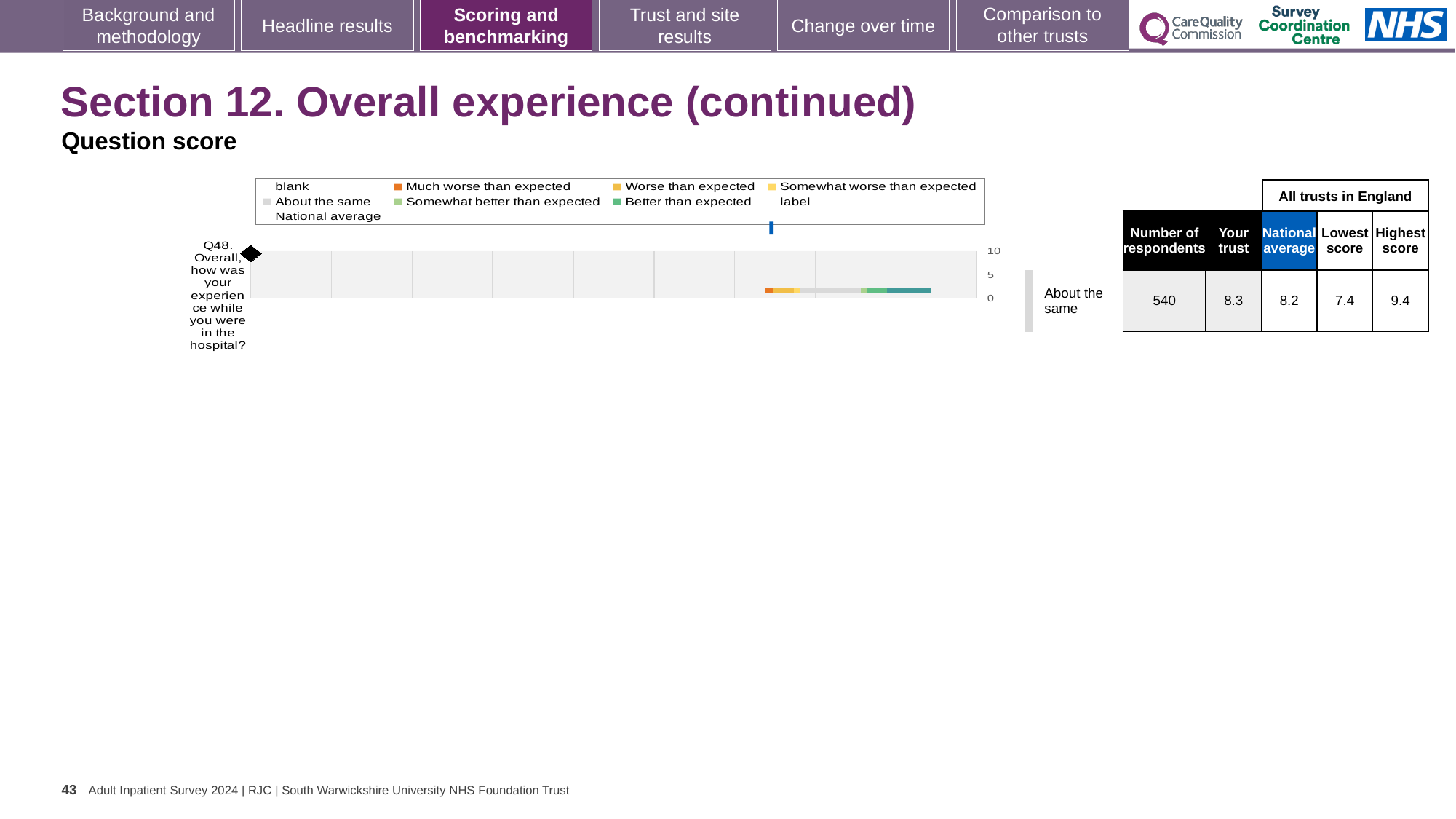
What is the lowest score among all trusts in England for Q48? 7.4 Which benchmarking category is Q48 assigned to? About the same What is the maximum value shown on the chart's score axis? 10 What is the 'Your trust' score for Q48 (Overall, how was your experience while you were in the hospital?)? 8.3 What is the national average score for Q48? 8.2 What is the difference between the highest score and the lowest score for Q48? 2.0 What kind of chart is used to show the Q48 question score? Bar chart What is the highest score among all trusts in England for Q48? 9.4 How many survey questions are plotted on the chart? 1 Which is larger for Q48: the 'Your trust' score or the national average? Your trust By how much does the 'Your trust' score for Q48 exceed the national average? 0.1 How many respondents answered Q48? 540